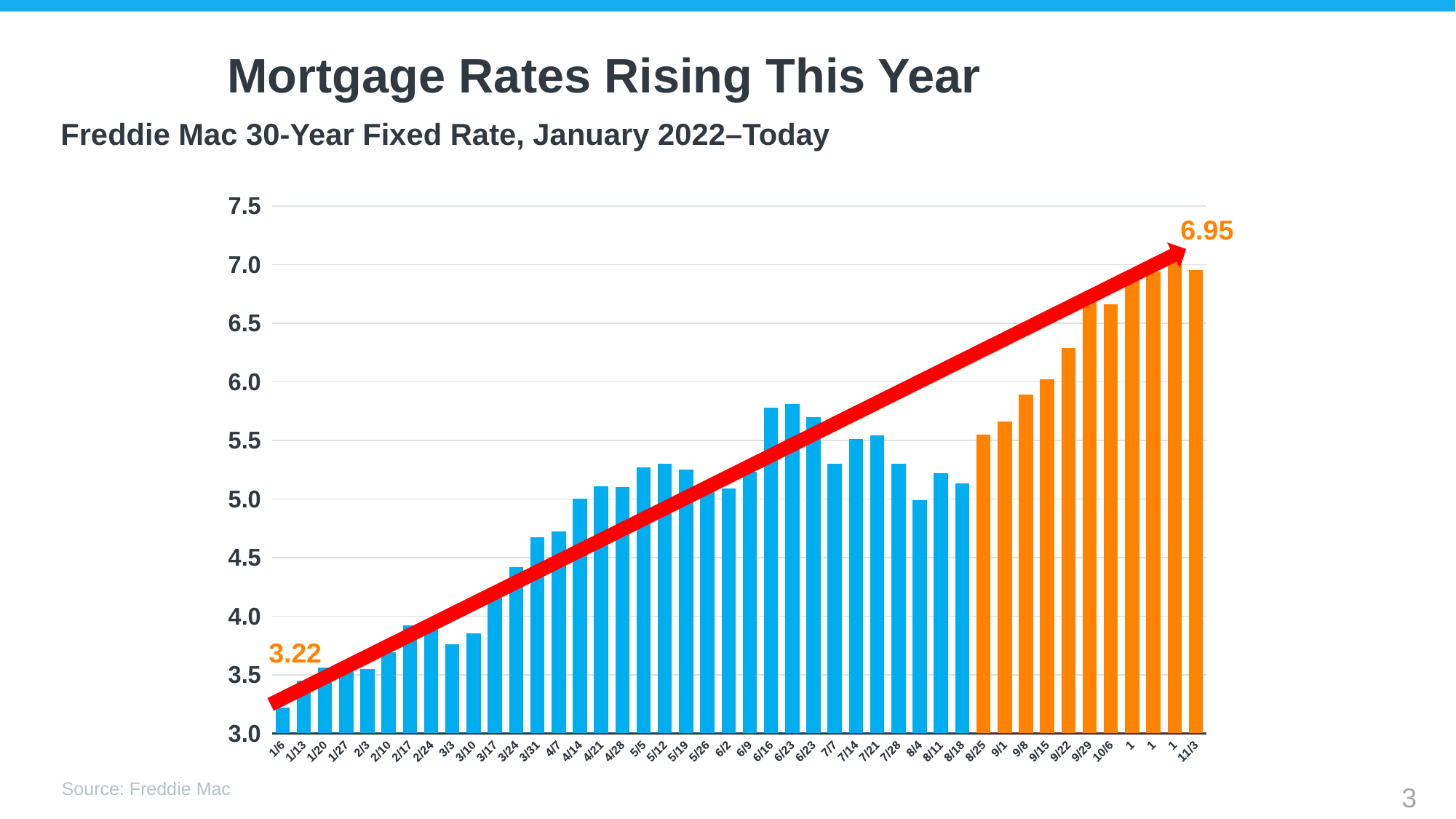
What is the mortgage rate shown for 1/6, the first bar on the chart? 3.22 What kind of chart is shown on the slide? Bar chart Is the value for 3/3 greater or less than 4.0? less What is the mortgage rate shown for 11/3, the last bar on the chart? 6.95 Is the value for 9/29 greater or less than 6.0? greater By how much did the rate rise from the first bar (1/6) to the last bar (11/3)? 3.73 Which is larger, the rate for 6/23 or the rate for 7/7? 6/23 What is the source cited for the chart data? Freddie Mac Which date has the lowest mortgage rate on the chart? 1/6 Is the value for 6/16 greater or less than 5.5? greater Do mortgage rates generally rise or fall from January 2022 to today along the x axis? Rise